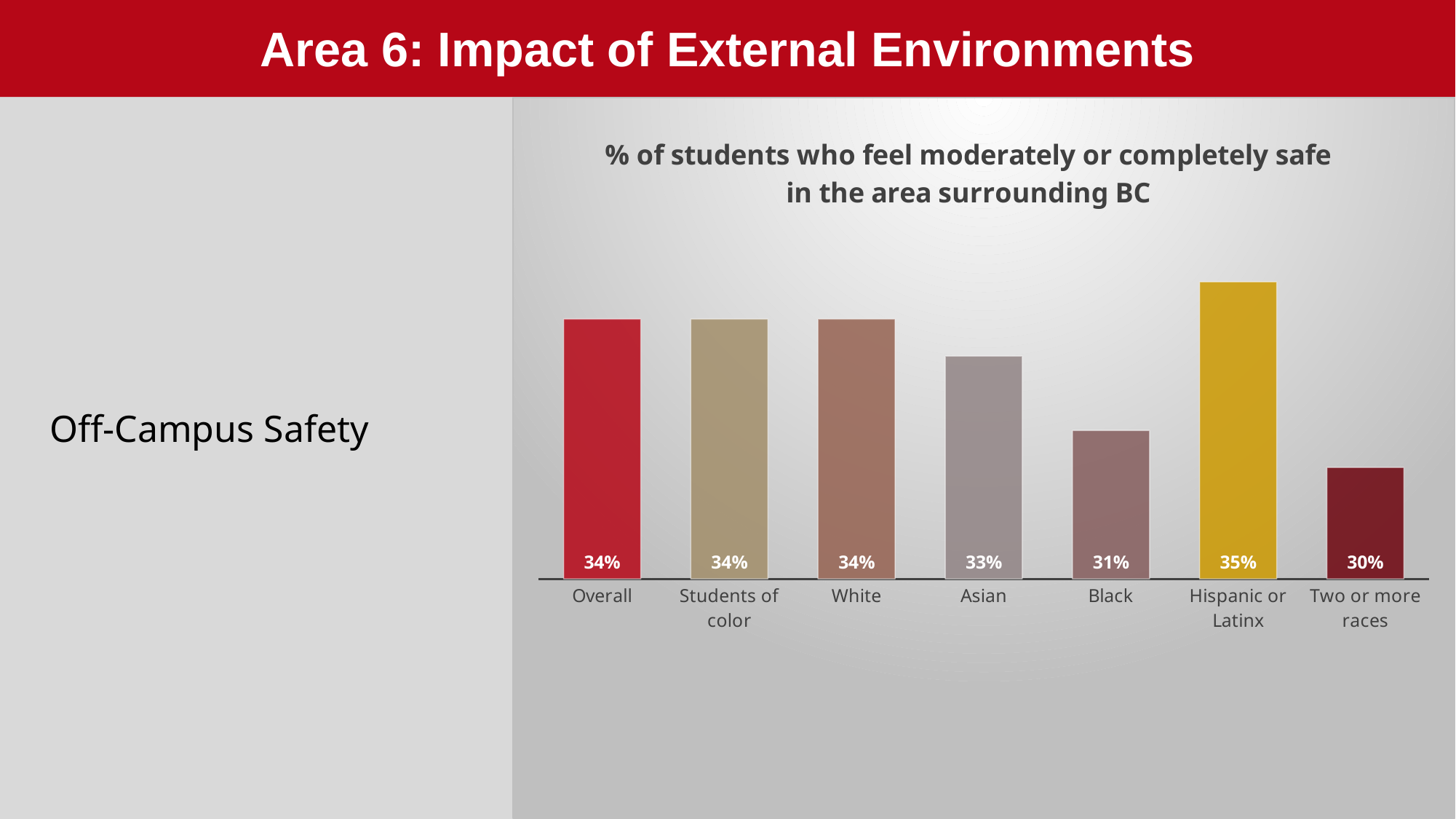
What is the value shown for Hispanic or Latinx students? 35% Which category has the lowest percentage of students who feel moderately or completely safe? Two or more races How many categories are shown in the chart? 7 What is the difference in percentage points between Hispanic or Latinx students and students of two or more races? 5 What type of chart is shown on the slide? Bar chart What percentage of students overall feel moderately or completely safe in the area surrounding BC? 34% What is the value shown for Asian students? 33% What is the title of the chart? % of students who feel moderately or completely safe in the area surrounding BC Which is larger, the value for Asian students or the value for Black students? Asian Which category has the highest percentage of students who feel moderately or completely safe? Hispanic or Latinx What is the value shown for Black students? 31% What is the value shown for students of two or more races? 30%